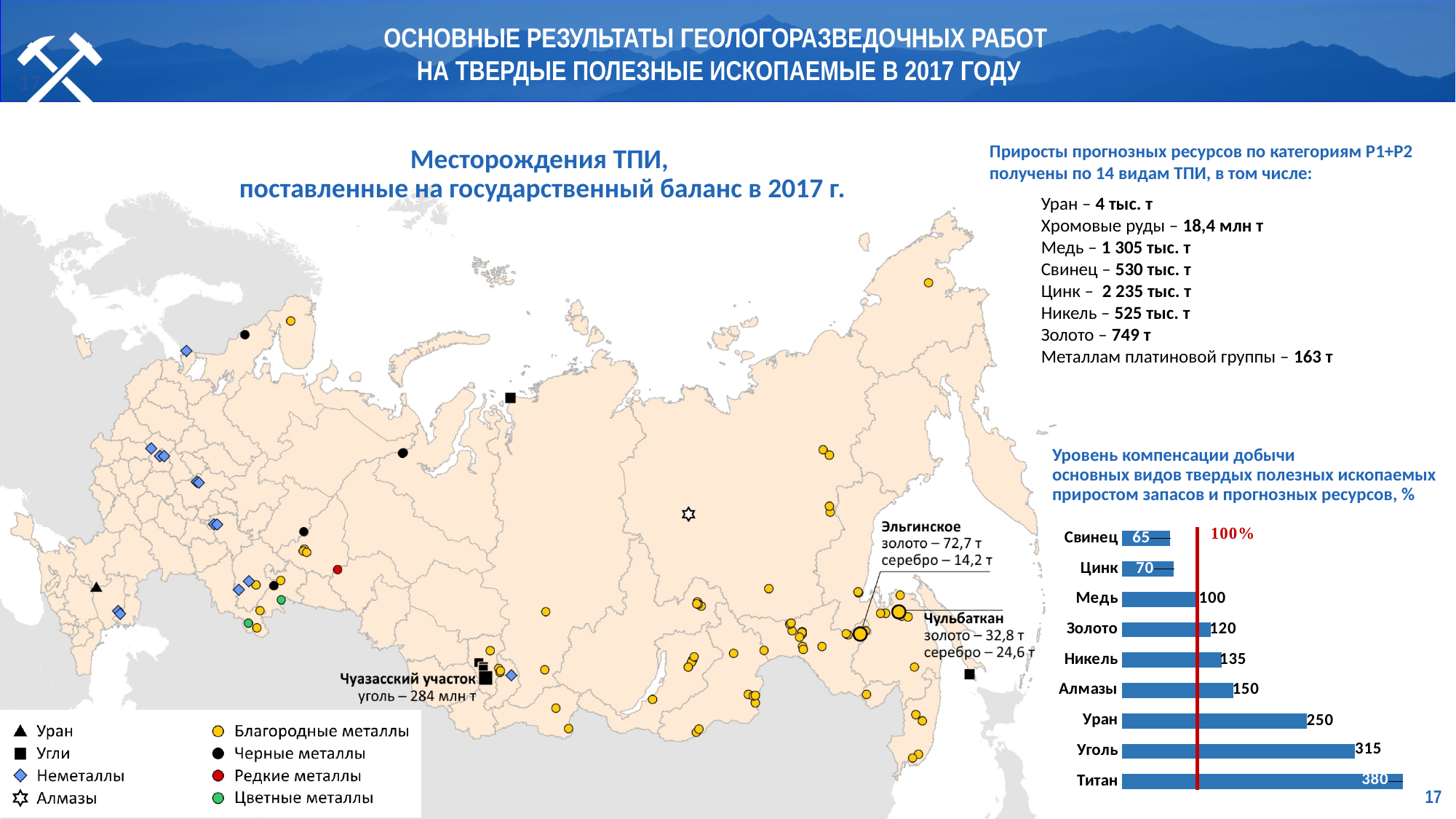
In the bar chart on the right, which category has the lowest value? Свинец What kind of chart is shown on the right side of the slide? bar chart In the bar chart on the right, what is the difference between the values for Уголь and Уран? 65 In the bar chart on the right, what is the value for Никель? 135 In the bar chart on the right, what is the value for Свинец? 65 In the bar chart on the right, what is the value for Медь? 100 In the bar chart on the right, which category has the highest value? Титан In the bar chart on the right, what is the value for Уран? 250 In the bar chart on the right, what value does the red vertical line mark? 100% In the bar chart on the right, is the value for Цинк greater or less than 100? less How many categories are shown in the bar chart on the right? 9 In the bar chart on the right, which is larger, the value for Алмазы or the value for Золото? Алмазы